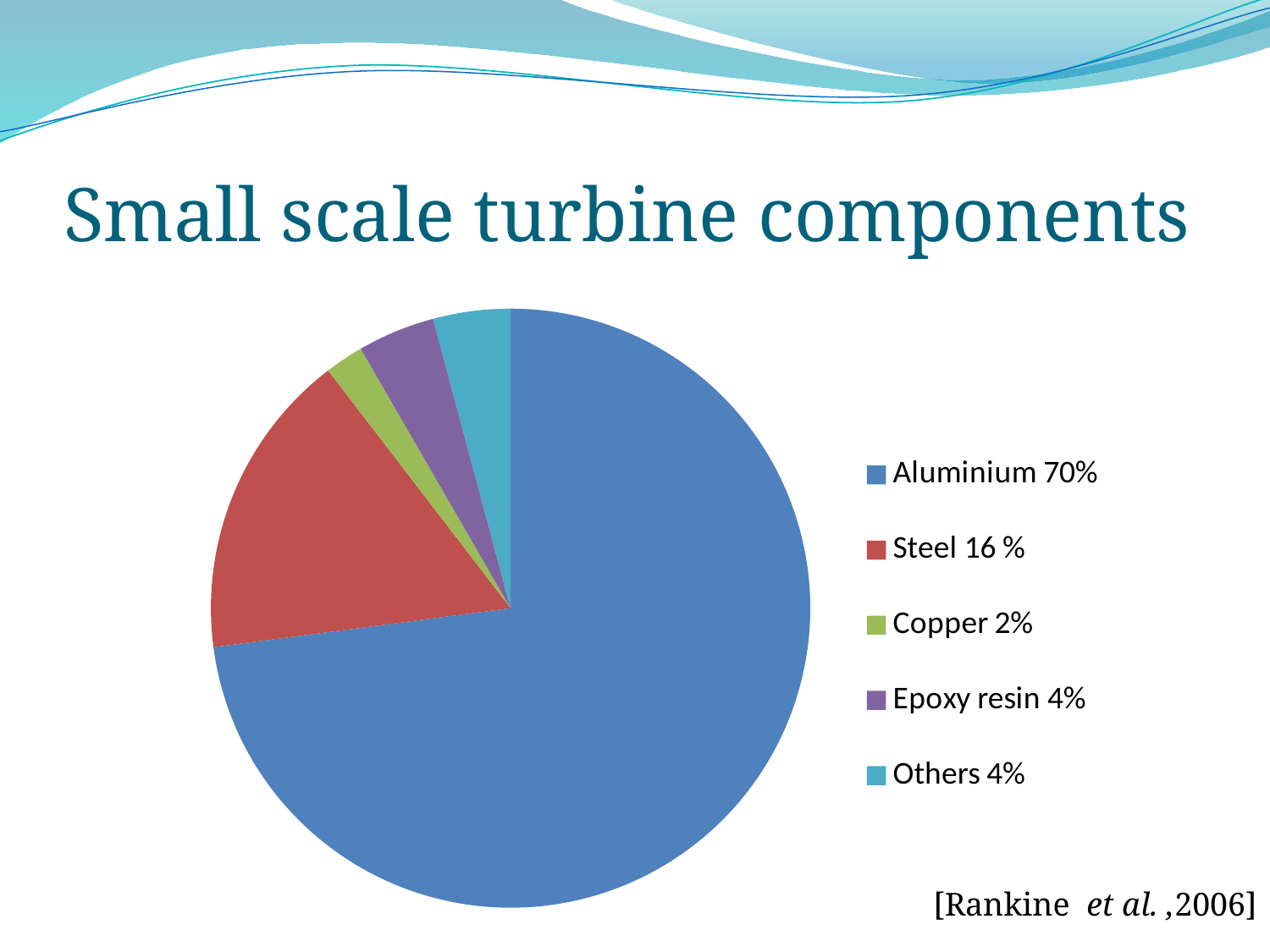
What percentage is shown for Copper? 2% What percentage is shown for Epoxy resin? 4% What share of the pie does Aluminium account for? 70% How many categories does the pie chart have? 5 What percentage is shown for Steel in the legend? 16 % Which material has the smallest slice of the pie? Copper Which material has the largest slice of the pie? Aluminium What is the combined share of Epoxy resin and Others? 8% Which is larger, the share for Steel or the share for Epoxy resin? Steel What is the difference in percentage points between Aluminium and Steel? 54 What type of chart is shown on the slide? pie chart What is the title of the slide containing the pie chart? Small scale turbine components